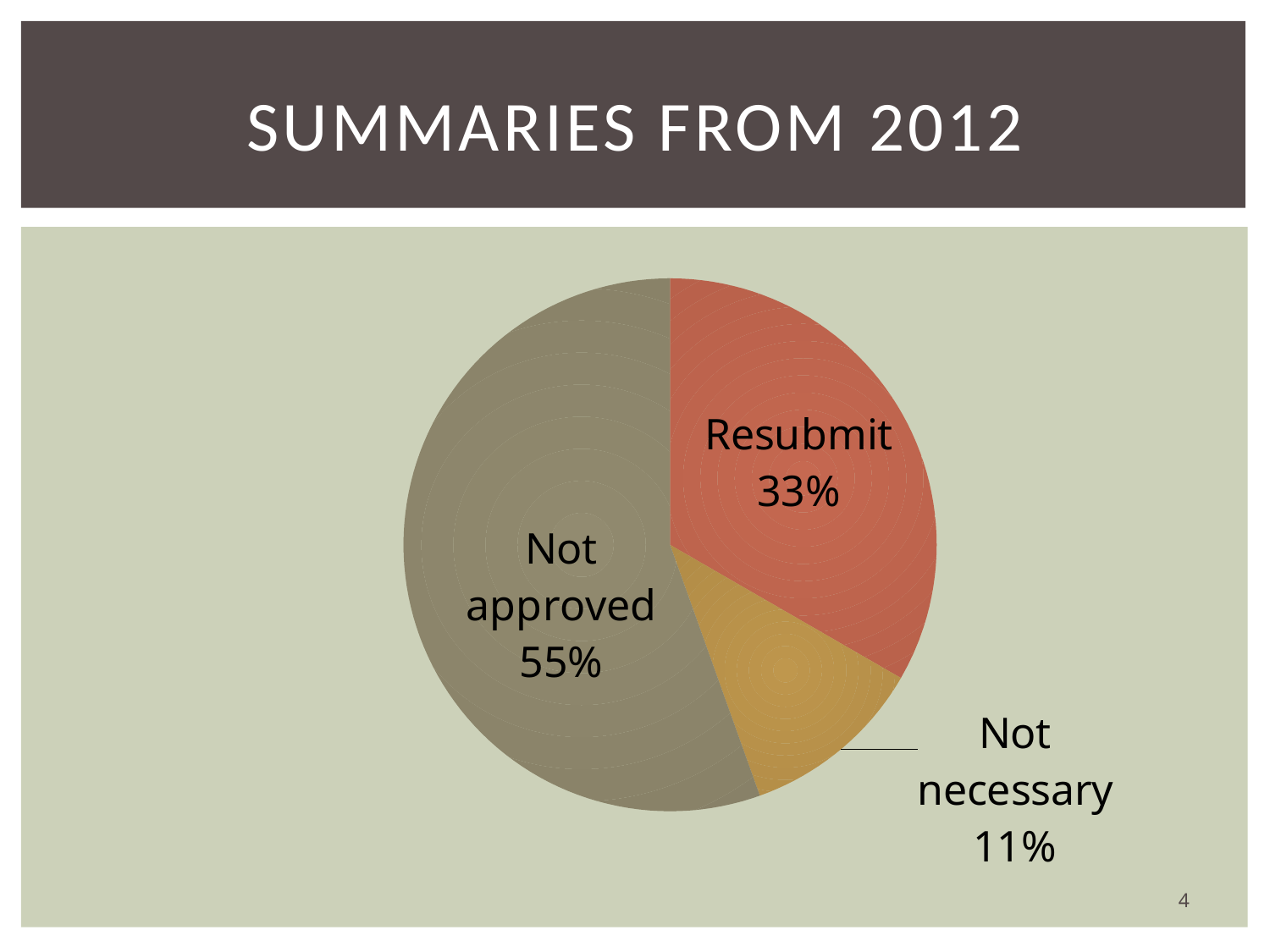
Which is larger, the Resubmit slice or the Not necessary slice? Resubmit What is the title of the slide containing the pie chart? SUMMARIES FROM 2012 Which slice of the pie is the largest? Not approved Which slice of the pie is the smallest? Not necessary What is the difference in percentage points between the Resubmit and Not necessary slices? 22 What colour is the Resubmit slice of the pie? red How many slices does the pie chart have? 3 What share of the pie is labelled Not necessary? 11% What share of the pie is labelled Not approved? 55% What is the difference in percentage points between the Not approved and Resubmit slices? 22 What share of the pie is labelled Resubmit? 33% What kind of chart is shown on the slide? pie chart